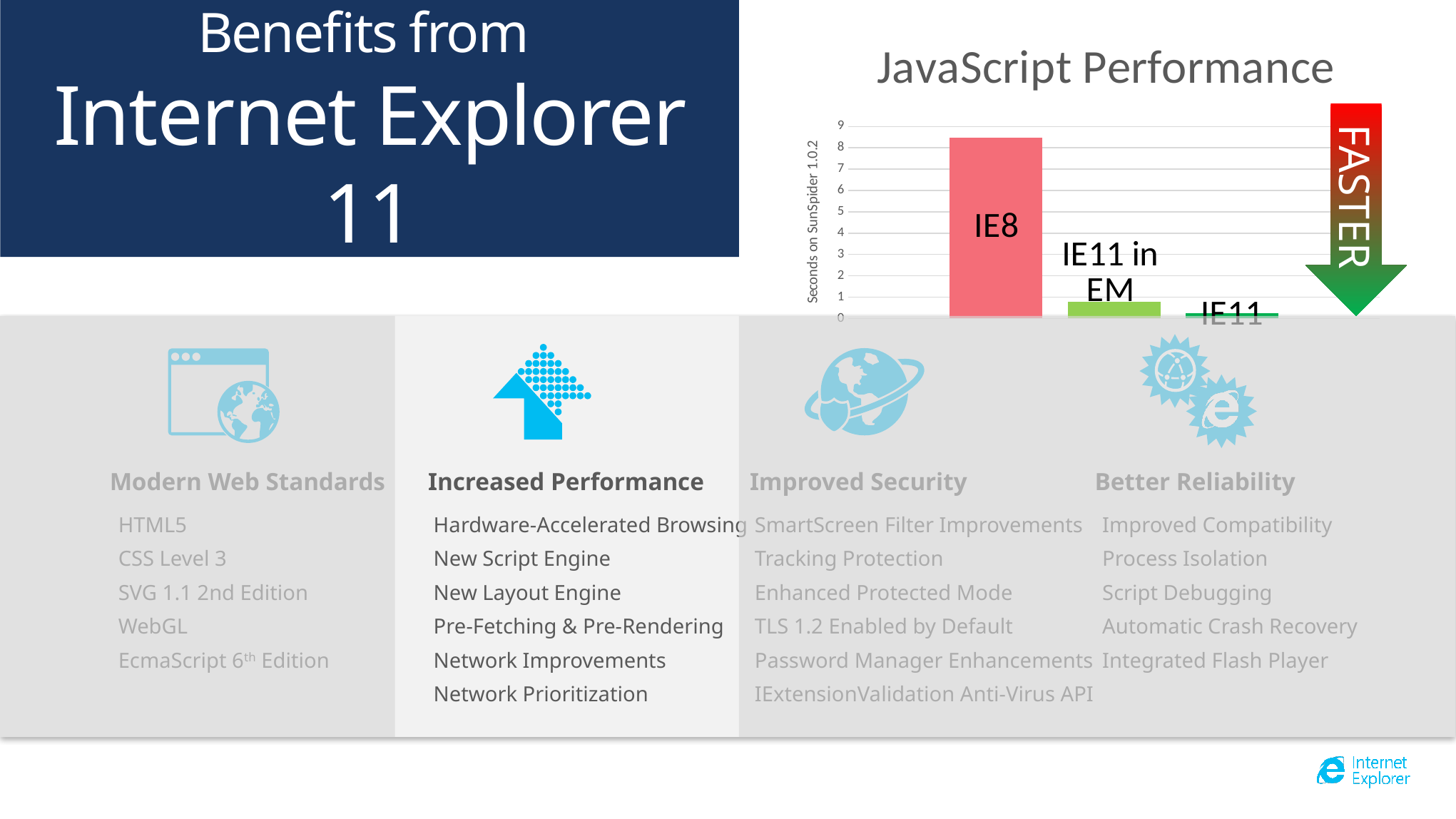
Is the value for IE8 greater or less than 8 seconds on the JavaScript Performance chart? greater What is the title of the chart on the slide? JavaScript Performance How many bars are plotted on the JavaScript Performance chart? 3 Is the value for IE11 greater or less than 1 second on the JavaScript Performance chart? less What is the label of the vertical axis on the JavaScript Performance chart? Seconds on SunSpider 1.0.2 What kind of chart is the JavaScript Performance chart? bar chart On the JavaScript Performance chart, which has the larger value, IE11 in EM or IE11? IE11 in EM Which browser has the highest value on the JavaScript Performance chart? IE8 On the JavaScript Performance chart, which has the larger value, IE8 or IE11 in EM? IE8 Is the value for IE11 in EM greater or less than 1 second on the JavaScript Performance chart? less Which browser has the lowest value on the JavaScript Performance chart? IE11 Do the values on the JavaScript Performance chart rise or fall from left to right? fall